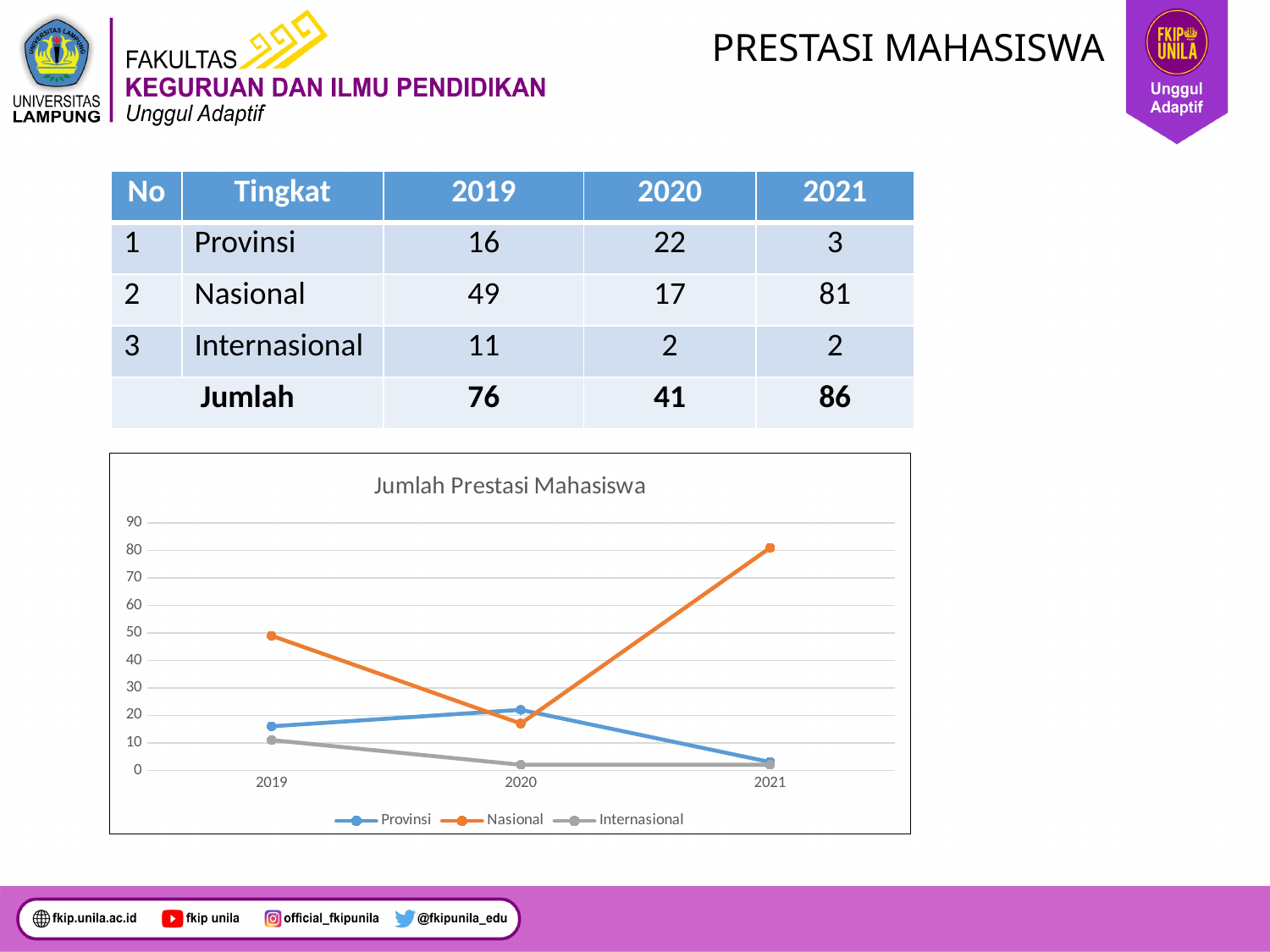
What is the value for Nasional in 2019, as printed in the table above the chart? 49 What kind of chart is shown on the slide? line chart Does the Nasional line rise or fall from 2020 to 2021? rise Does the Internasional line rise or fall from 2019 to 2020? fall Which series has the lowest value in 2019? Internasional How many series does the chart legend list? 3 Is the value for Nasional in 2021 greater or less than 80? greater Which series has the highest value in 2021? Nasional How many years are shown on the x axis of the chart? 3 Is the value for Provinsi in 2021 greater or less than 10? less What is the title of the chart? Jumlah Prestasi Mahasiswa Which is larger in 2020, Provinsi or Nasional? Provinsi